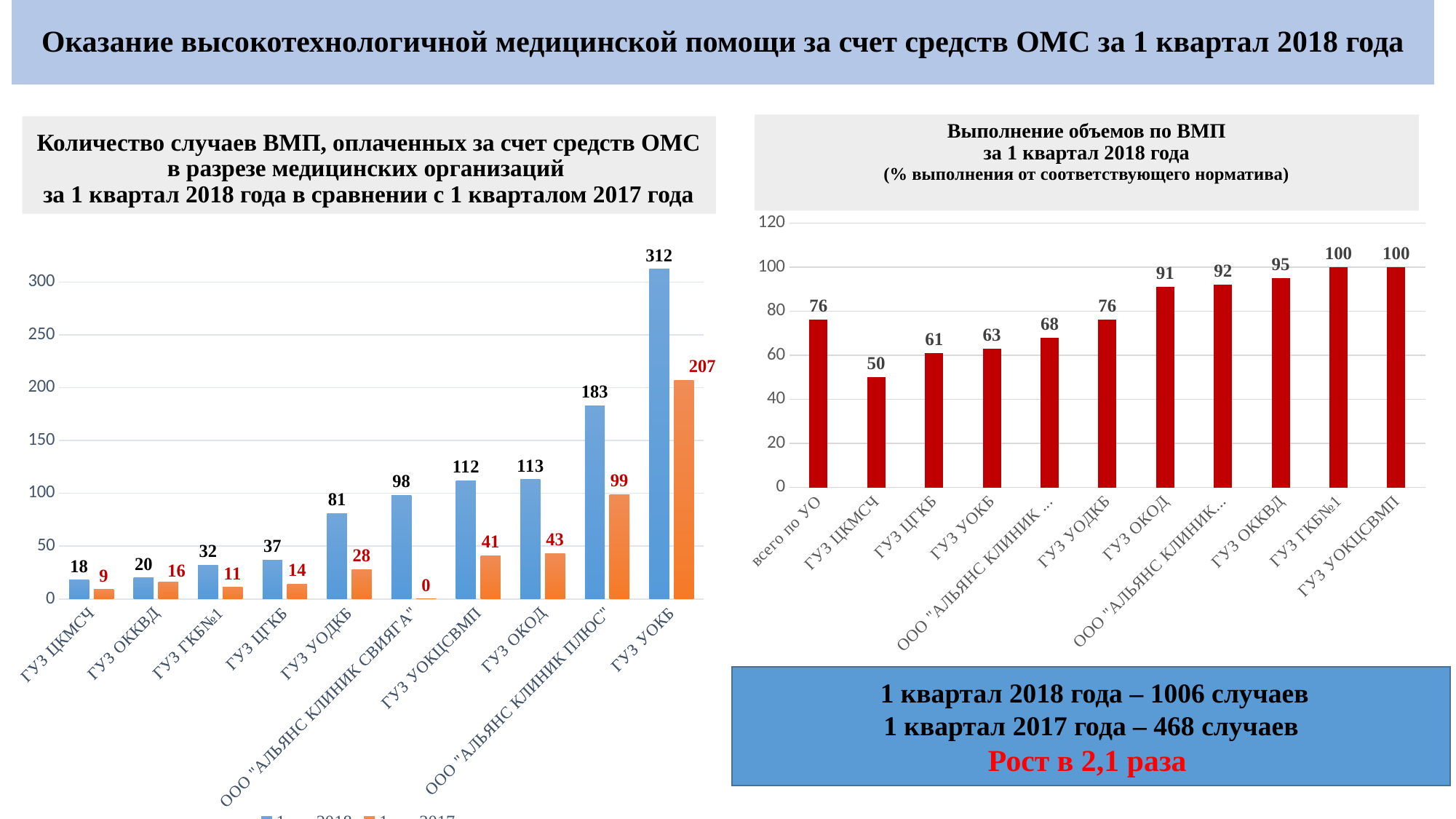
In the right chart, which category has the lowest value? ГУЗ ЦКМСЧ In the right chart, how many bars are plotted? 11 In the right chart, what is the value for всего по УО? 76 In the right chart, what is the value for ГУЗ ЦКМСЧ? 50 In the left chart, what is the 2017 value (orange bar) for ООО "АЛЬЯНС КЛИНИК ПЛЮС"? 99 In the left chart, which organisation has the highest blue (2018) bar? ГУЗ УОКБ What kind of chart is the left chart? Bar chart In the left chart, which organisation has the lowest orange (2017) bar? ООО "АЛЬЯНС КЛИНИК СВИЯГА" In the left chart, how many organisations are shown on the x axis? 10 In the right chart, is the value for ГУЗ ОККВД larger than the value for ГУЗ ОКОД? Yes In the left chart, what is the difference between the blue and orange bars for ГУЗ УОКБ? 105 In the left chart, what is the 2018 value (blue bar) for ГУЗ УОКБ? 312